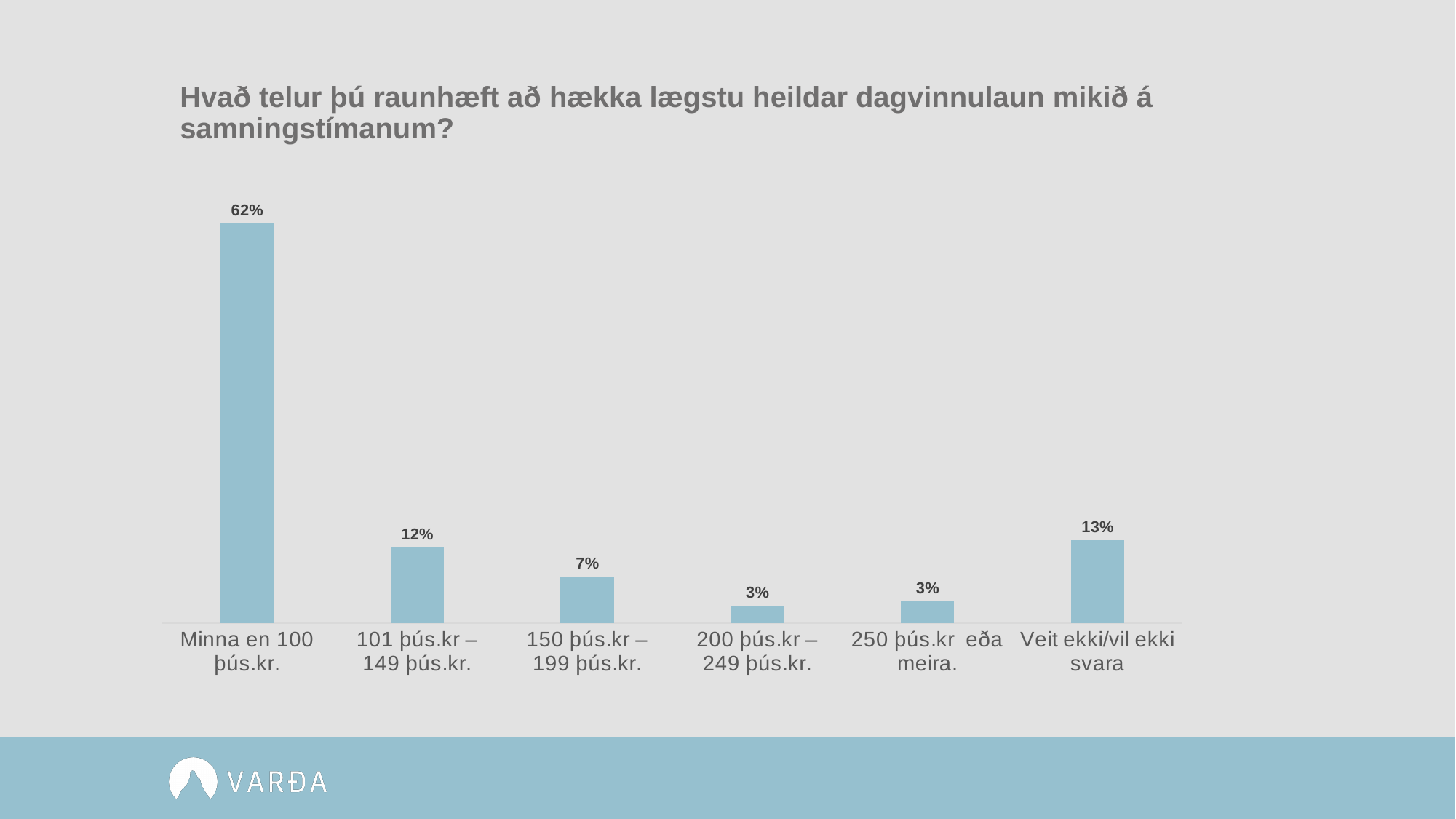
Which category has the highest value? Minna en 100 þús.kr. What is the value for '101 þús.kr – 149 þús.kr.'? 12% How many categories are shown on the chart? 6 What is the value for '200 þús.kr – 249 þús.kr.'? 3% What is the difference between the values for '101 þús.kr – 149 þús.kr.' and '150 þús.kr – 199 þús.kr.'? 5% What is the value for '150 þús.kr – 199 þús.kr.'? 7% What kind of chart is shown on the slide? Bar chart Which is larger, the value for '101 þús.kr – 149 þús.kr.' or the value for 'Veit ekki/vil ekki svara'? Veit ekki/vil ekki svara What is the value for 'Veit ekki/vil ekki svara'? 13% What is the difference between the values for 'Minna en 100 þús.kr.' and 'Veit ekki/vil ekki svara'? 49% What is the value for 'Minna en 100 þús.kr.'? 62% What colour are the bars in the chart? Light blue